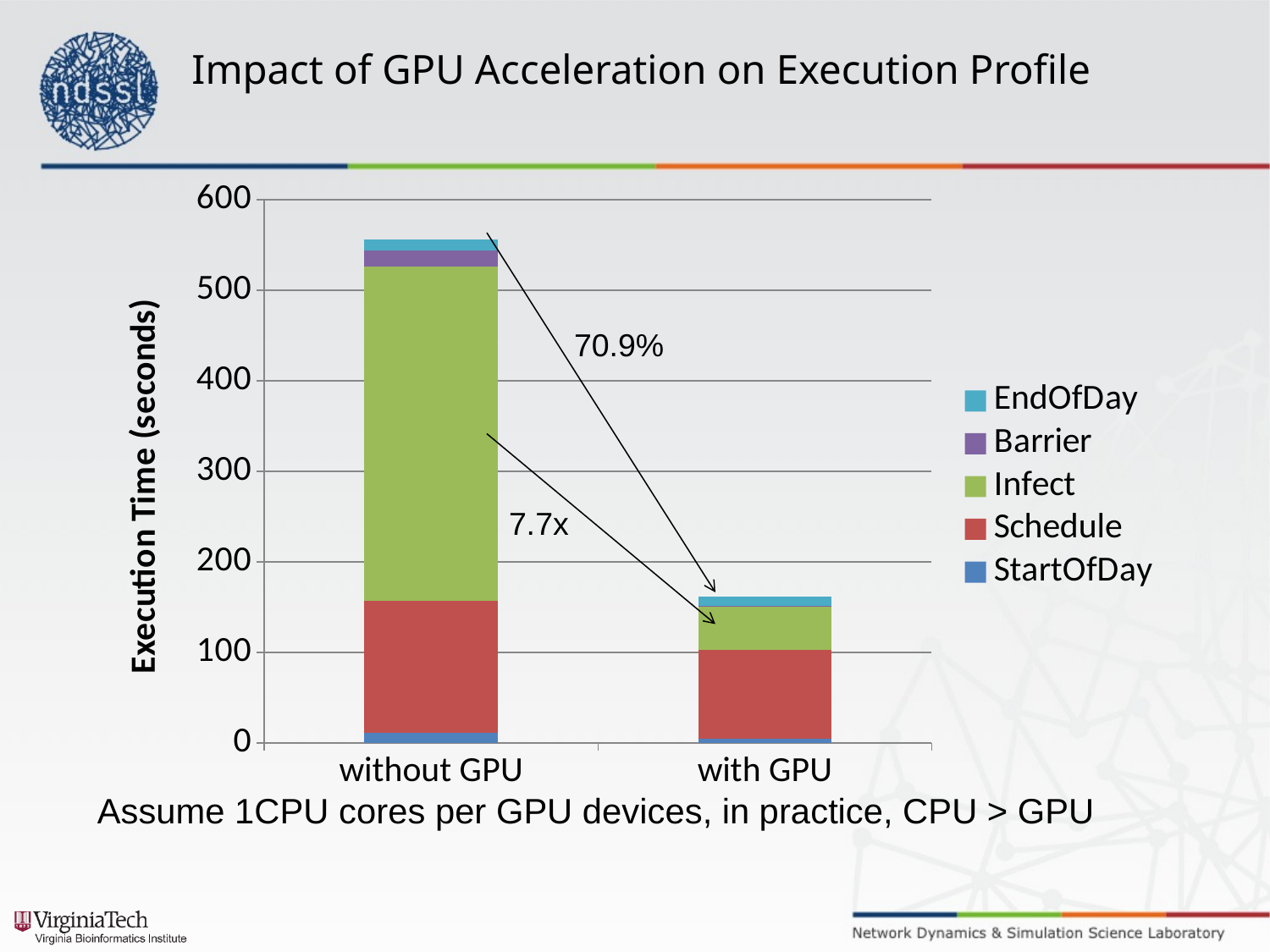
Which category has the higher total execution time? without GPU What is the title of the y axis? Execution Time (seconds) Is the total execution time for without GPU greater or less than 500? greater What kind of chart is shown on the slide? stacked bar chart Is the total execution time for with GPU greater or less than 200? less Which category has the lower total execution time? with GPU How many categories are shown on the x axis? 2 Does the total execution time rise or fall from without GPU to with GPU? fall In the without GPU bar, which segment is larger, Infect or Schedule? Infect Is the Infect segment for without GPU greater or less than 300? greater How many series does the legend list? 5 What speedup factor is annotated on the chart between the two bars? 7.7x